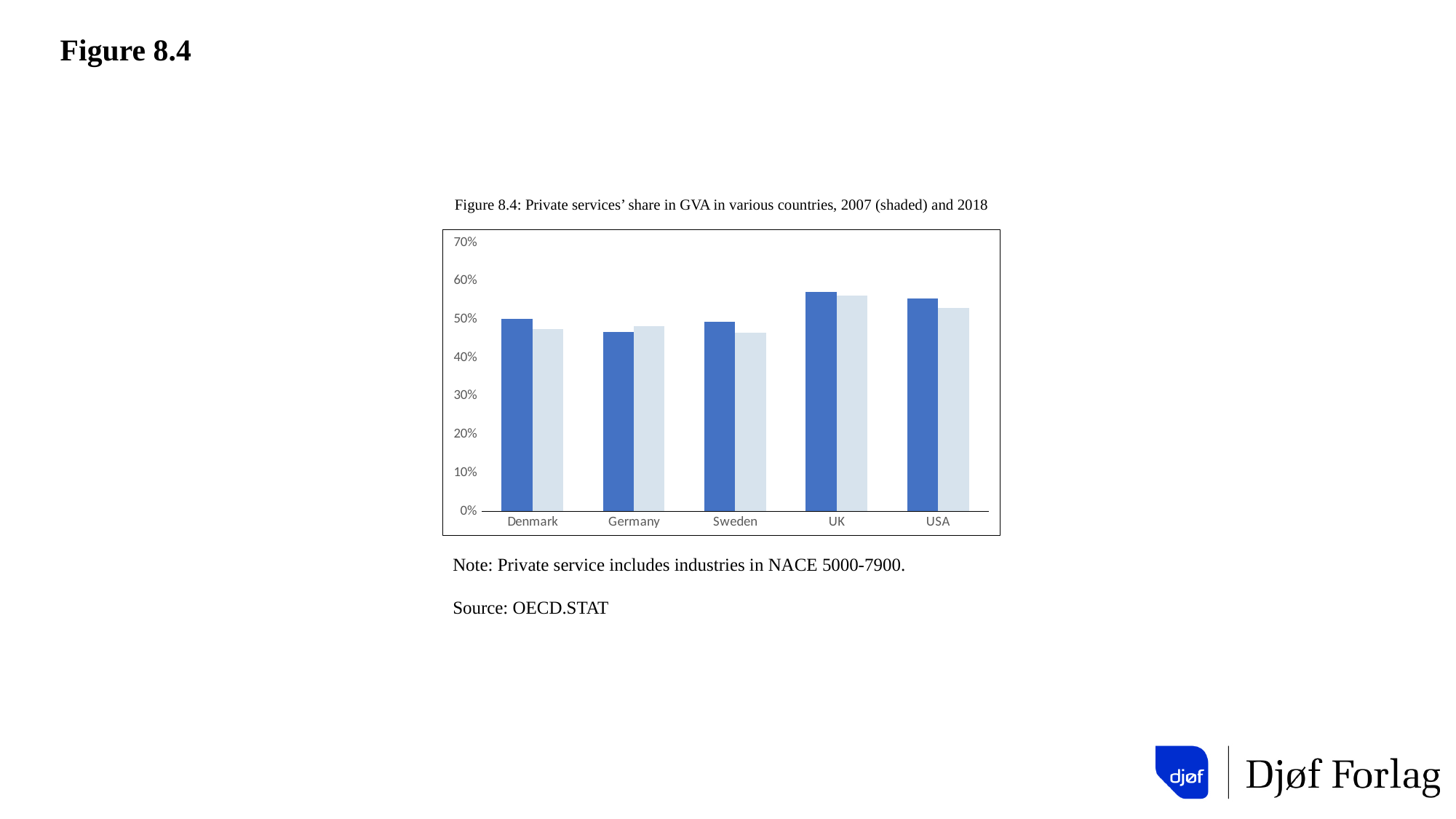
How many countries are shown on the x axis of the chart? 5 What kind of chart is shown on the slide? Bar chart For Denmark, which is larger: the 2007 (shaded) value or the 2018 value? 2018 Is the 2018 value for Germany greater or less than 50%? less Which country has the lowest private services' share in GVA in 2018 (dark bar)? Germany What is the source given for the chart? OECD.STAT Is the 2007 (shaded) value for USA greater or less than 50%? greater Which country has the highest private services' share in GVA in 2018 (dark bar)? UK Which country has the highest private services' share in GVA in 2007 (shaded bar)? UK For Sweden, which is larger: the 2007 (shaded) value or the 2018 value? 2018 Is the 2018 value for UK greater or less than 50%? greater How many bars are plotted for each country in the chart? 2